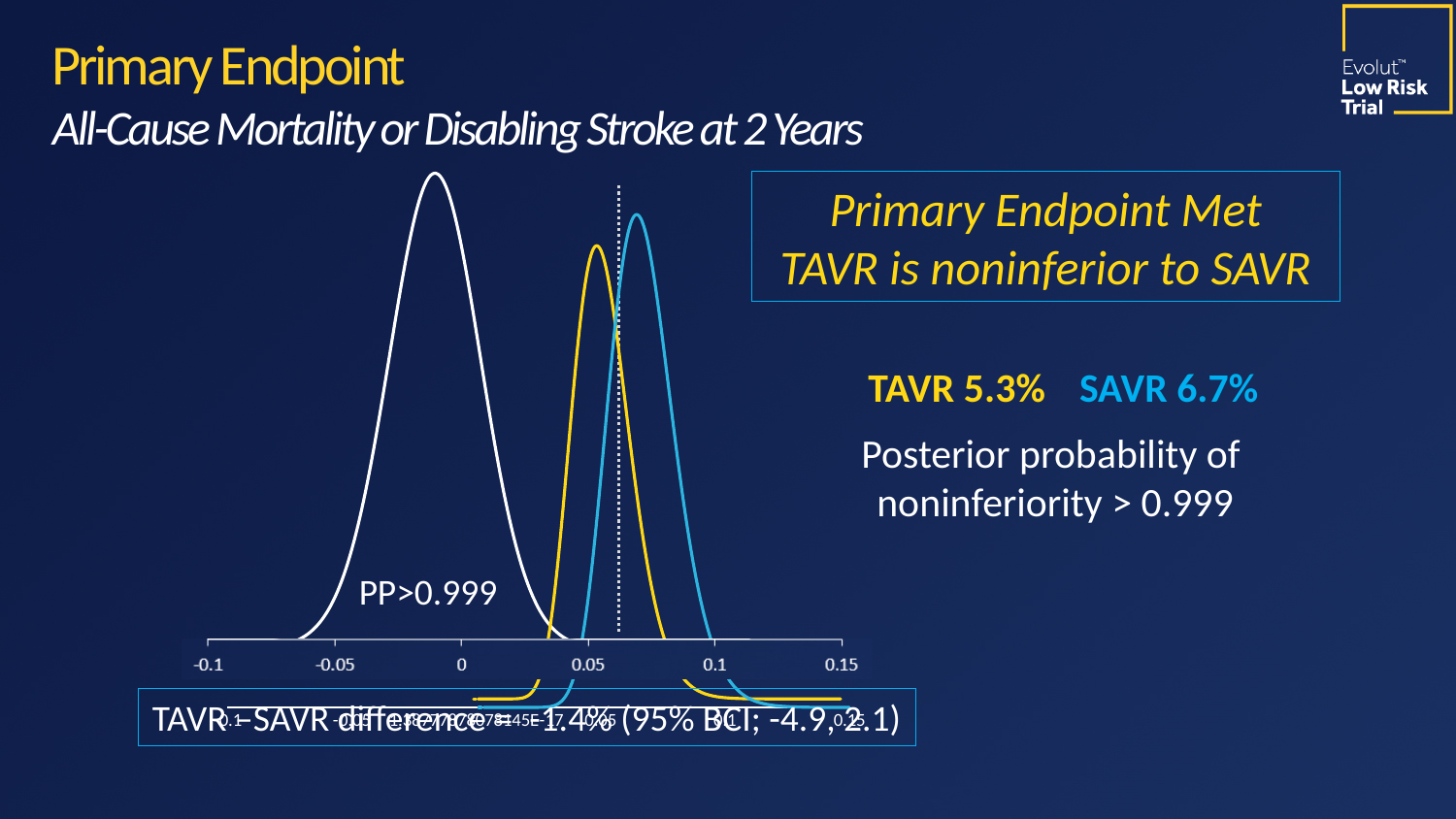
Which curve peaks further to the right on the x axis, the yellow curve or the blue curve? the blue curve What TAVR–SAVR difference is reported on the slide? -1.4% (95% BCI; -4.9, 2.1) Is the peak of the blue curve located at an x value greater or less than 0.05? greater How many curves are plotted on the chart? 3 Is the peak of the white curve located at an x value greater or less than 0.05? less What kind of chart is shown on the slide? line chart What is the highest tick label on the x axis of the chart? 0.15 What is the 2-year rate of all-cause mortality or disabling stroke for TAVR shown on the slide? 5.3% What is the lowest tick label on the x axis of the chart? -0.1 What is the 2-year rate of all-cause mortality or disabling stroke for SAVR shown on the slide? 6.7% How many tick labels are shown on the x axis of the chart? 6 Which curve reaches the highest peak on the chart? the white curve